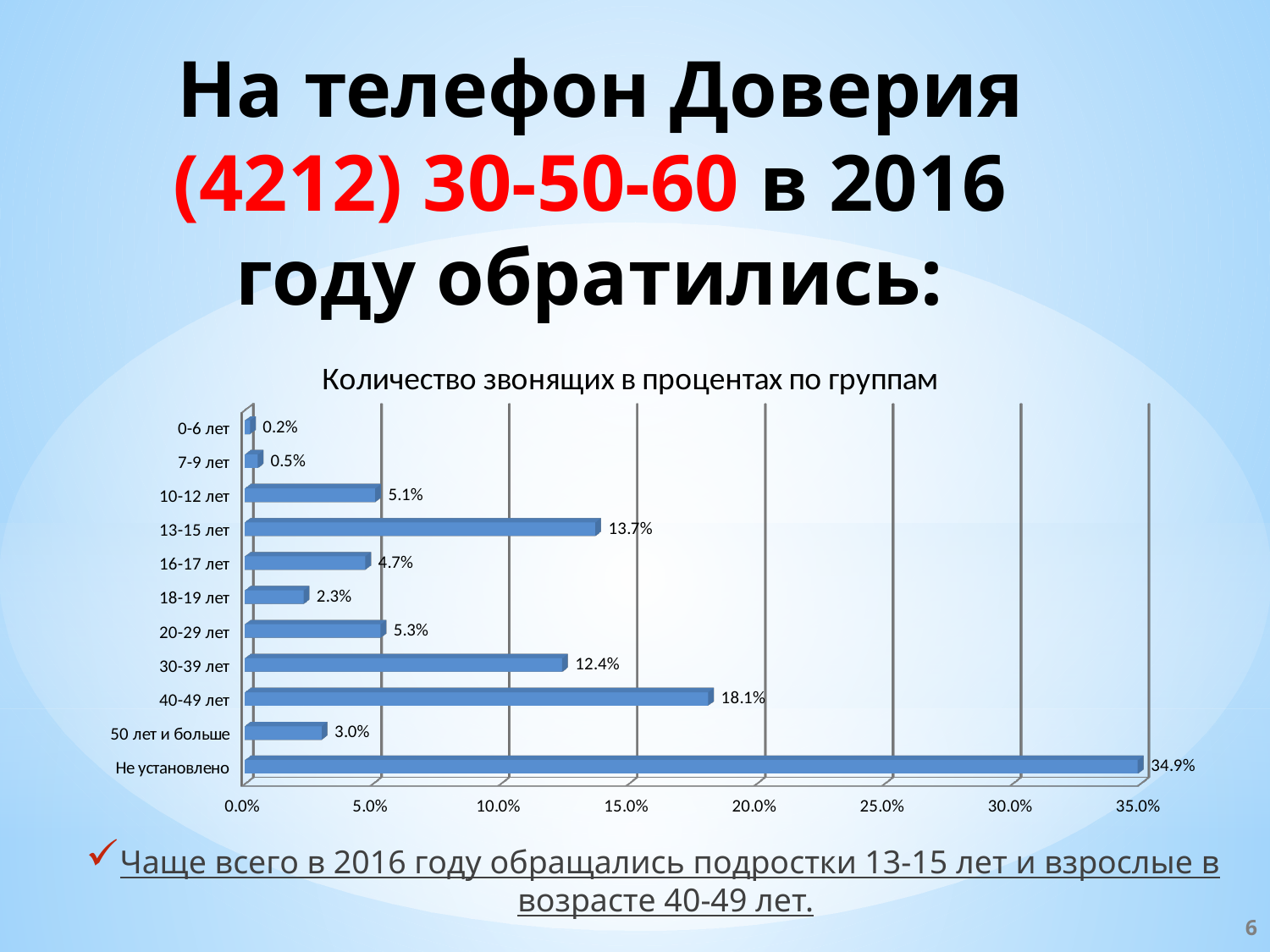
What is the difference between the values for 40-49 лет and 13-15 лет? 4.4% What is the value for the 13-15 лет category? 13.7% Which is larger, the value for 30-39 лет or the value for 20-29 лет? 30-39 лет What is the value for the 0-6 лет category? 0.2% Which category has the lowest value? 0-6 лет What is the value for the 40-49 лет category? 18.1% Which category has the highest value? Не установлено How many categories are shown in the chart? 11 What kind of chart is shown on the slide? bar chart What is the value for the 50 лет и больше category? 3.0% What is the title of the chart? Количество звонящих в процентах по группам Is the value for Не установлено greater or less than 30.0%? greater